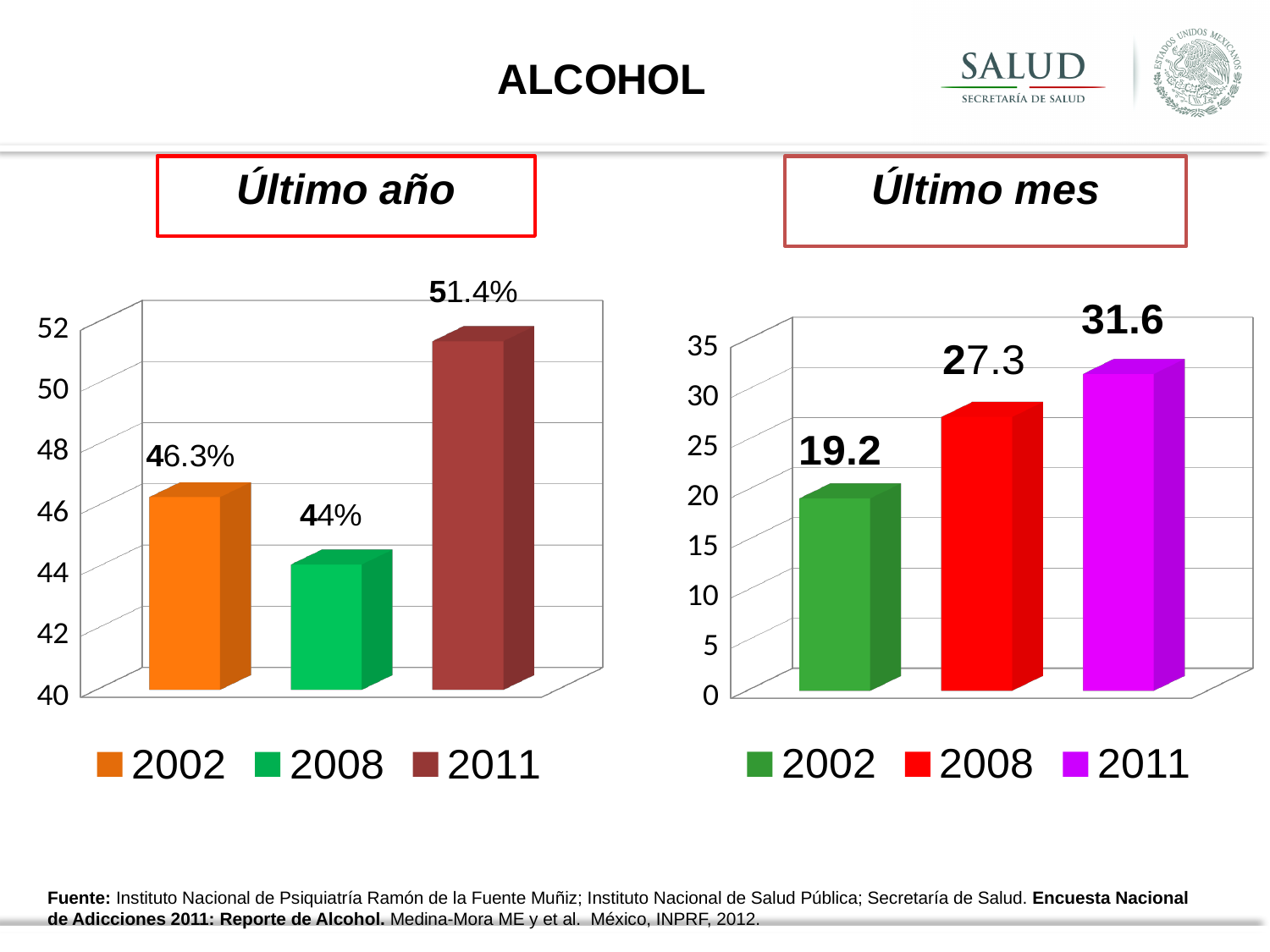
How many bars are plotted in the 'Último mes' chart? 3 In the 'Último año' chart, which is larger, the value for 2002 or the value for 2008? 2002 In the 'Último mes' chart, what is the difference between the 2011 and 2002 values? 12.4 In the 'Último mes' chart, what is the value for 2008? 27.3 In the 'Último año' chart, what is the value for 2002? 46.3% In the 'Último año' chart, what is the value for 2011? 51.4% In the 'Último año' chart, what is the difference between the 2011 and 2008 values? 7.4% In the 'Último año' chart, which year has the lowest value? 2008 What type of chart is the 'Último mes' chart? Bar chart In the 'Último mes' chart, what is the value for 2002? 19.2 In the 'Último mes' chart, which year has the highest value? 2011 How many entries does the legend of the 'Último año' chart list? 3